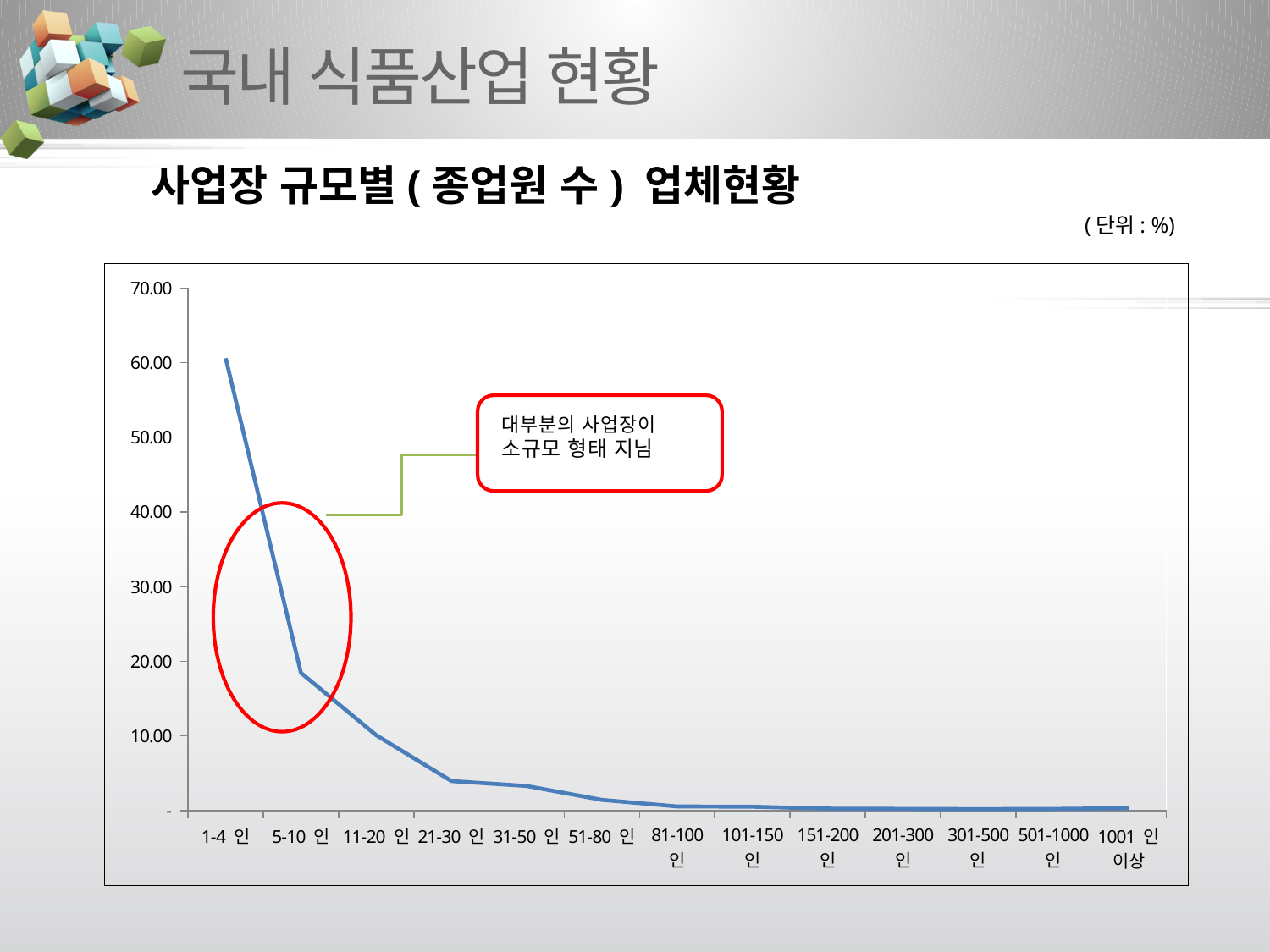
Is the value for 5-10 인 greater or less than 20? less Is the value for 1-4 인 greater or less than 50? greater Is the value for 21-30 인 greater or less than 10? less Which has the larger value, 1-4 인 or 5-10 인? 1-4 인 What kind of chart is shown on the slide? line chart Which employee-size category has the highest value? 1-4 인 Which has the larger value, 11-20 인 or 21-30 인? 11-20 인 How many employee-size categories are plotted along the x axis? 13 What unit is stated for the chart values? % Do the values rise or fall as you move from left to right along the x axis? fall